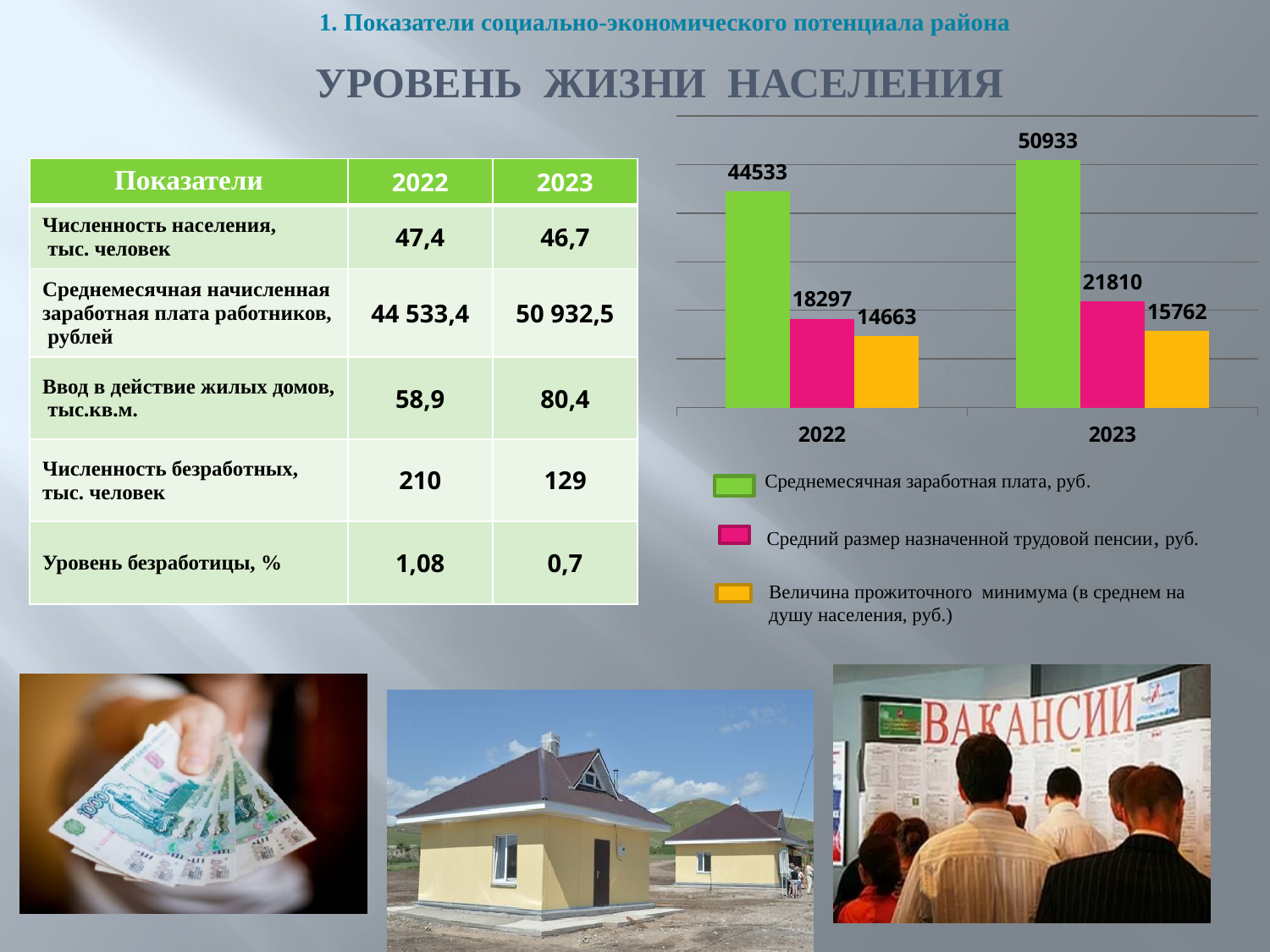
What is the difference between the average pension and the subsistence minimum in the chart for 2023? 6048 By how much did the average monthly wage in the chart increase from 2022 to 2023? 6400 What is the average monthly wage (Среднемесячная заработная плата) shown in the chart for 2023? 50933 How many year categories are shown on the x axis of the chart? 2 What is the average assigned pension (Средний размер назначенной трудовой пенсии) shown in the chart for 2022? 18297 Which series has the lowest value in the chart for 2022? Величина прожиточного минимума Does the average pension in the chart rise or fall from 2022 to 2023? rise What is the subsistence minimum (Величина прожиточного минимума) shown in the chart for 2023? 15762 What is the average monthly wage (Среднемесячная заработная плата) shown in the chart for 2022? 44533 How many series does the chart's legend list? 3 Which year has the higher subsistence minimum in the chart, 2022 or 2023? 2023 What type of chart is shown on the slide? bar chart